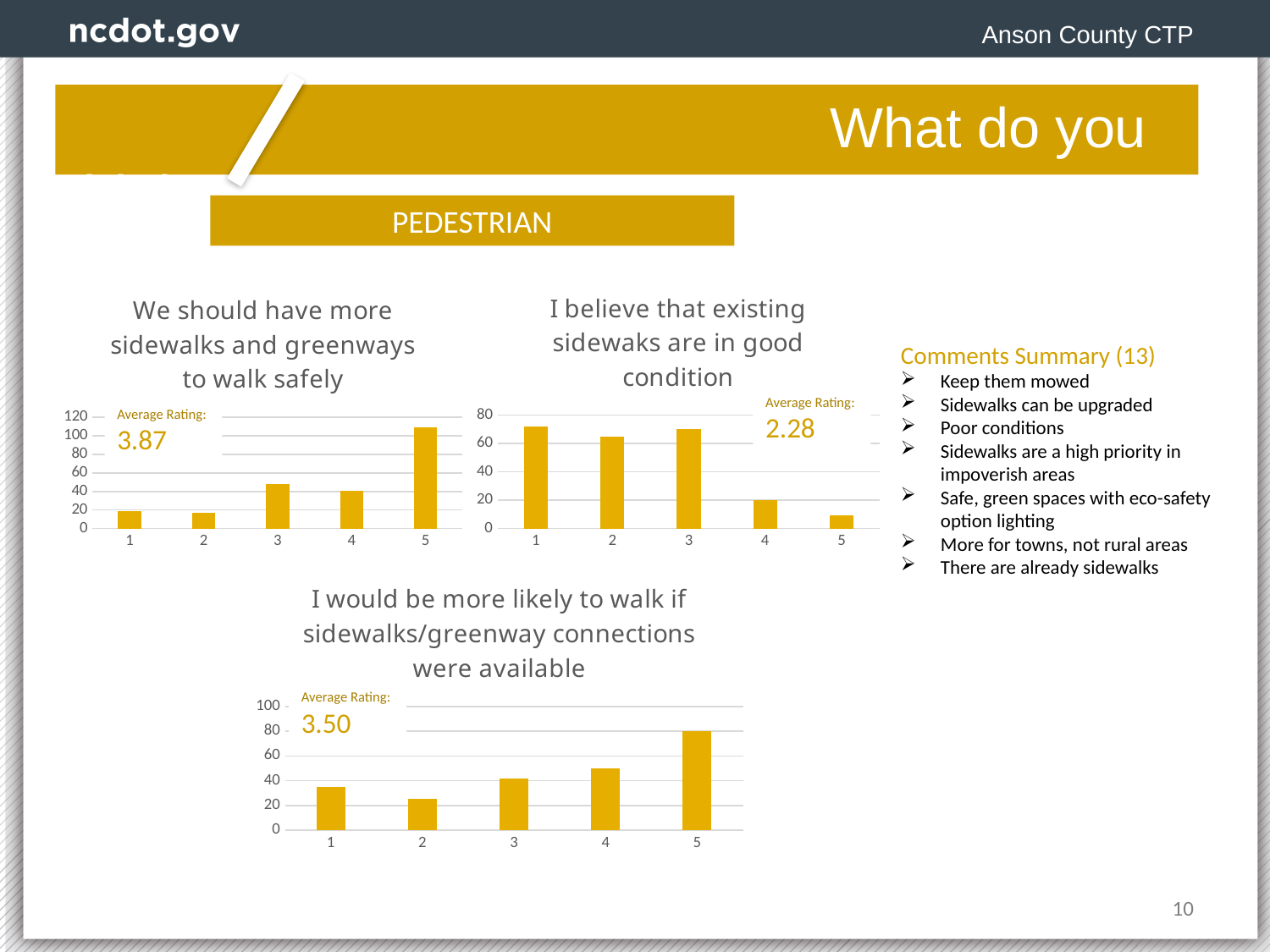
In the chart titled "I would be more likely to walk if sidewalks/greenway connections were available", which rating category has the shortest bar? 2 In the chart titled "I would be more likely to walk if sidewalks/greenway connections were available", which rating category has the tallest bar? 5 What is the average rating shown on the chart titled "I believe that existing sidewaks are in good condition"? 2.28 What is the average rating shown on the chart titled "We should have more sidewalks and greenways to walk safely"? 3.87 In the chart titled "I believe that existing sidewaks are in good condition", is the value for rating 4 greater or less than 40? less In the chart titled "I believe that existing sidewaks are in good condition", which rating category has the shortest bar? 5 What is the average rating shown on the chart titled "I would be more likely to walk if sidewalks/greenway connections were available"? 3.50 How many rating categories are shown on the x axis of the chart titled "We should have more sidewalks and greenways to walk safely"? 5 In the chart titled "I would be more likely to walk if sidewalks/greenway connections were available", is the value for rating 5 greater or less than 60? greater In the chart titled "We should have more sidewalks and greenways to walk safely", is the value for rating 5 greater or less than 100? greater In the chart titled "We should have more sidewalks and greenways to walk safely", which rating category has the tallest bar? 5 In the chart titled "I believe that existing sidewaks are in good condition", which is larger, the value for rating 2 or the value for rating 4? rating 2